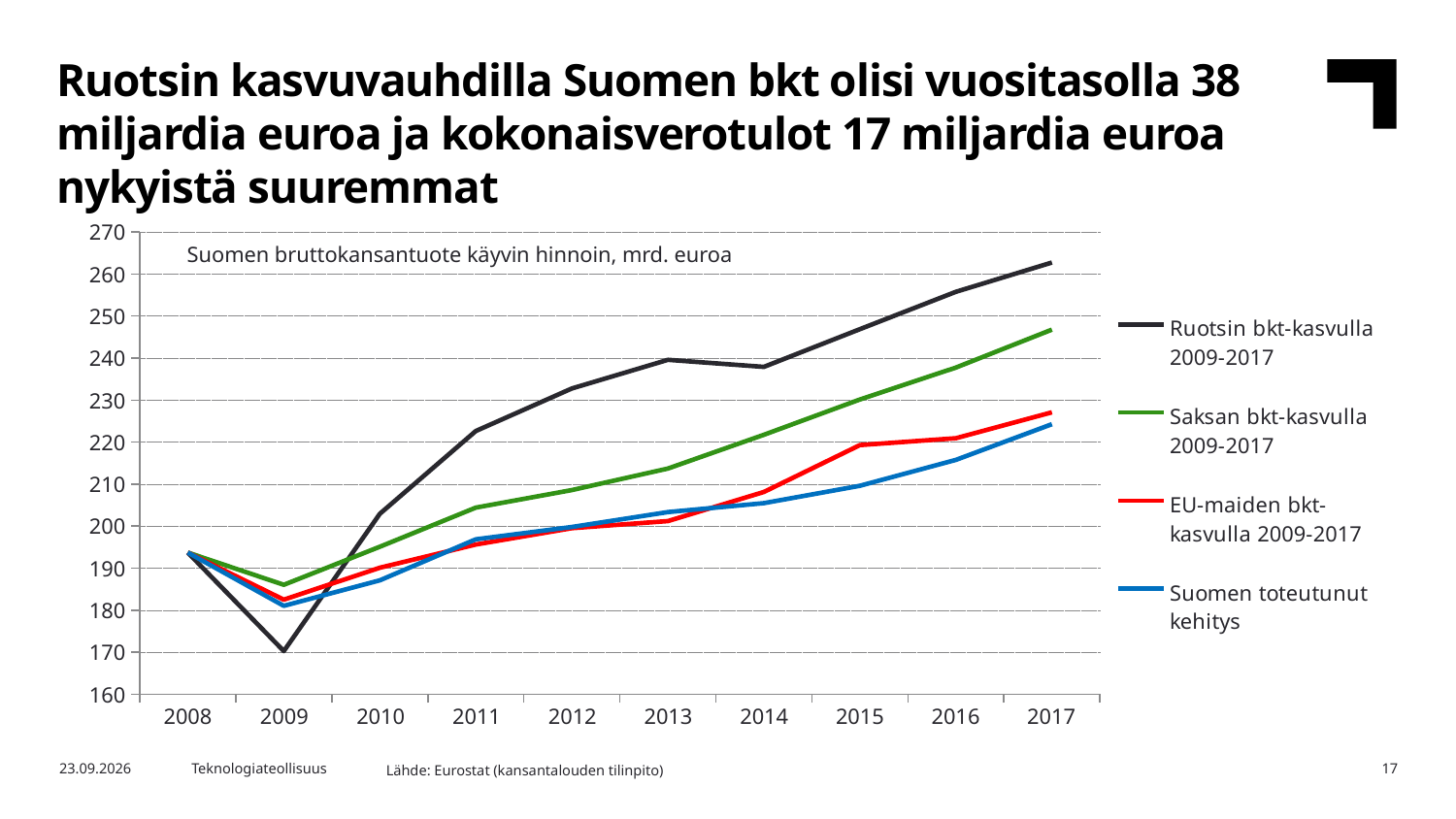
Does the Ruotsin bkt-kasvulla 2009-2017 series rise or fall from 2009 to 2017? Rise Which series has the highest value in 2017? Ruotsin bkt-kasvulla 2009-2017 Is the value for Ruotsin bkt-kasvulla 2009-2017 in 2009 greater or less than 180? less How many series does the legend list? 4 What is the title text shown inside the chart area? Suomen bruttokansantuote käyvin hinnoin, mrd. euroa How many years are shown on the x axis? 10 Is the value for Suomen toteutunut kehitys in 2017 greater or less than 230? less Is the value for Ruotsin bkt-kasvulla 2009-2017 in 2017 greater or less than 250? greater Which series has the lowest value in 2009? Ruotsin bkt-kasvulla 2009-2017 Which series has the lowest value in 2017? Suomen toteutunut kehitys What kind of chart is shown on the slide? Line chart In 2015, which is higher: EU-maiden bkt-kasvulla 2009-2017 or Suomen toteutunut kehitys? EU-maiden bkt-kasvulla 2009-2017